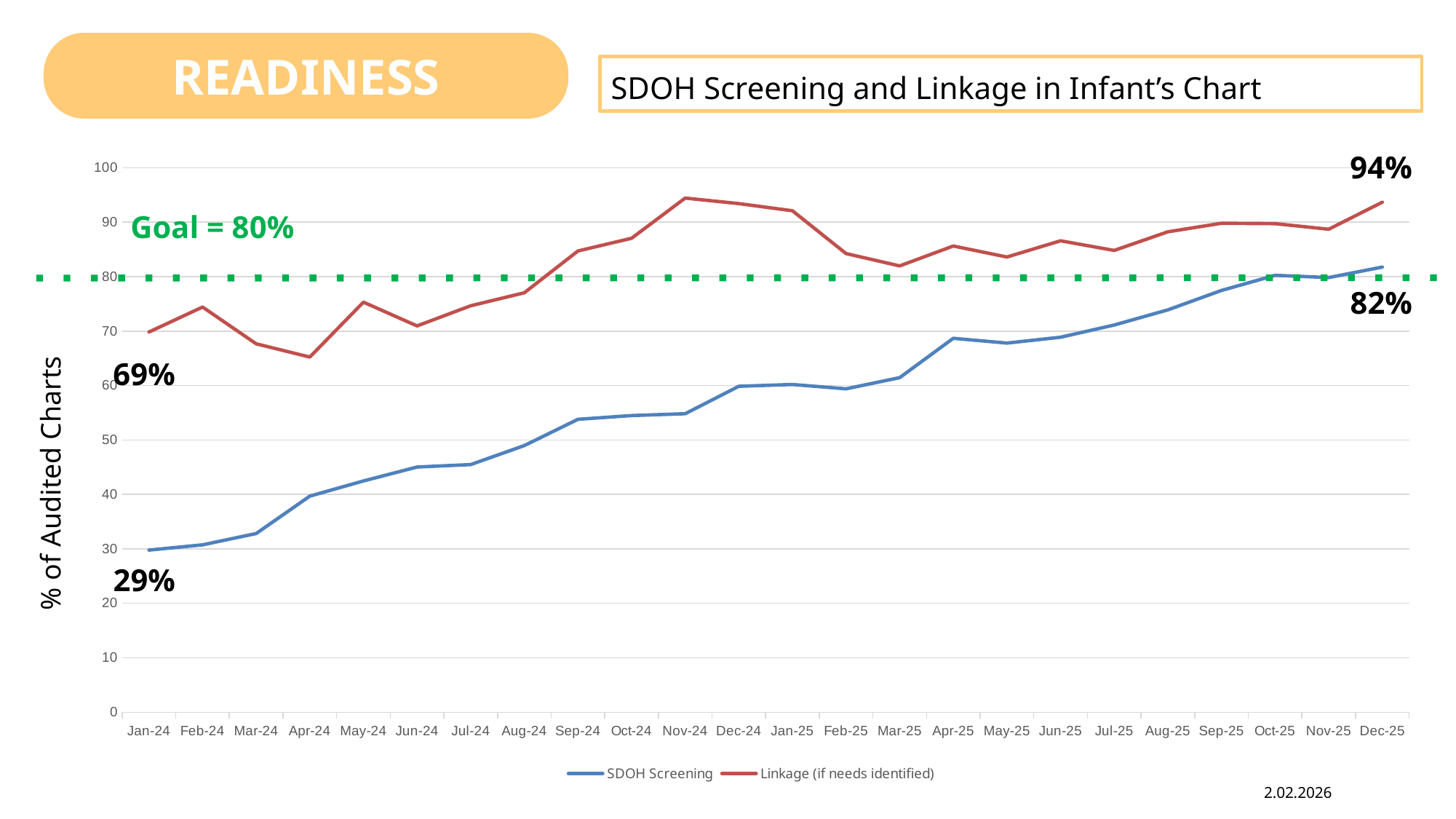
How many months are shown on the x axis? 24 What is the SDOH Screening value for Jan-24? 29% What is the Linkage (if needs identified) value for Jan-24? 69% Is the Linkage (if needs identified) value for Nov-24 greater or less than 90? greater What kind of chart is shown on the slide? line chart What is the SDOH Screening value for Dec-25? 82% What is the Linkage (if needs identified) value for Dec-25? 94% By how many percentage points did Linkage (if needs identified) increase from Jan-24 to Dec-25? 25 Is the SDOH Screening value for Jun-24 greater or less than 50? less By how many percentage points did SDOH Screening increase from Jan-24 to Dec-25? 53 How many series does the legend list? 2 In Dec-25, which series has the higher value, SDOH Screening or Linkage (if needs identified)? Linkage (if needs identified)